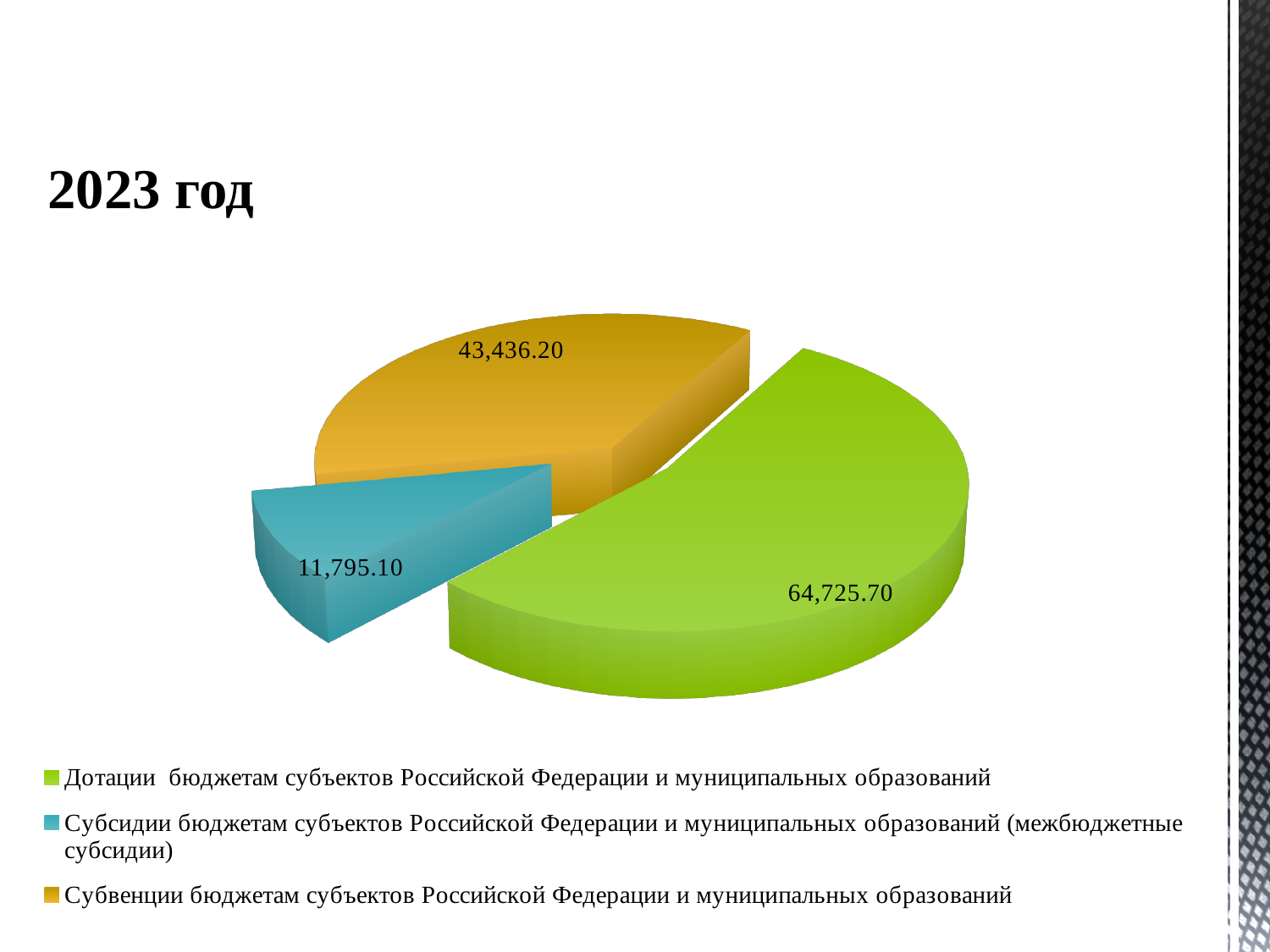
How many slices does the pie chart have? 3 What kind of chart is shown on the slide? Pie chart Which category has the largest slice of the pie? Дотации бюджетам субъектов Российской Федерации и муниципальных образований What is the total of all three slices of the pie? 119,957.00 What is the value for Субсидии бюджетам субъектов Российской Федерации и муниципальных образований (межбюджетные субсидии)? 11,795.10 Which is larger, the value for Субвенции or the value for Субсидии? Субвенции What is the difference between the value for Субвенции and the value for Субсидии? 31,641.10 What is the difference between the value for Дотации and the value for Субвенции? 21,289.50 What is the title of the chart? 2023 год Which category has the smallest slice of the pie? Субсидии бюджетам субъектов Российской Федерации и муниципальных образований (межбюджетные субсидии) What is the value for Субвенции бюджетам субъектов Российской Федерации и муниципальных образований? 43,436.20 What is the value for Дотации бюджетам субъектов Российской Федерации и муниципальных образований? 64,725.70